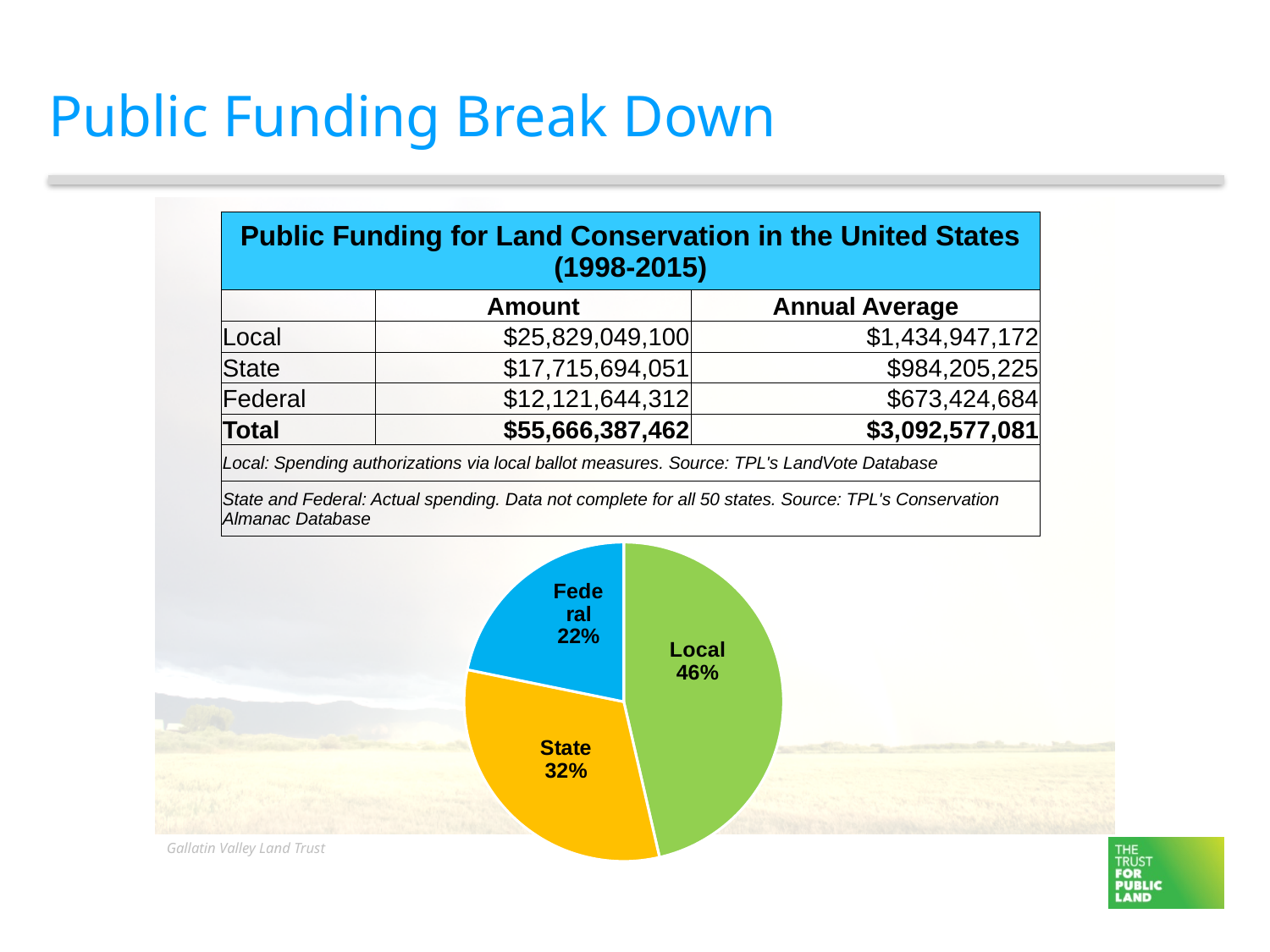
What kind of chart is shown on the slide? pie chart What share of the pie chart does the State slice represent? 32% In the pie chart, what is the difference in percentage points between the Local slice and the State slice? 14 Which slice of the pie chart is the largest? Local In the pie chart, what is the difference in percentage points between the Local slice and the Federal slice? 24 What colour is the Local slice in the pie chart? green How many slices does the pie chart have? 3 In the pie chart, which is larger, the State slice or the Federal slice? State What share of the pie chart does the Federal slice represent? 22% Which slice of the pie chart is the smallest? Federal What share of the pie chart does the Local slice represent? 46% What colour is the Federal slice in the pie chart? blue